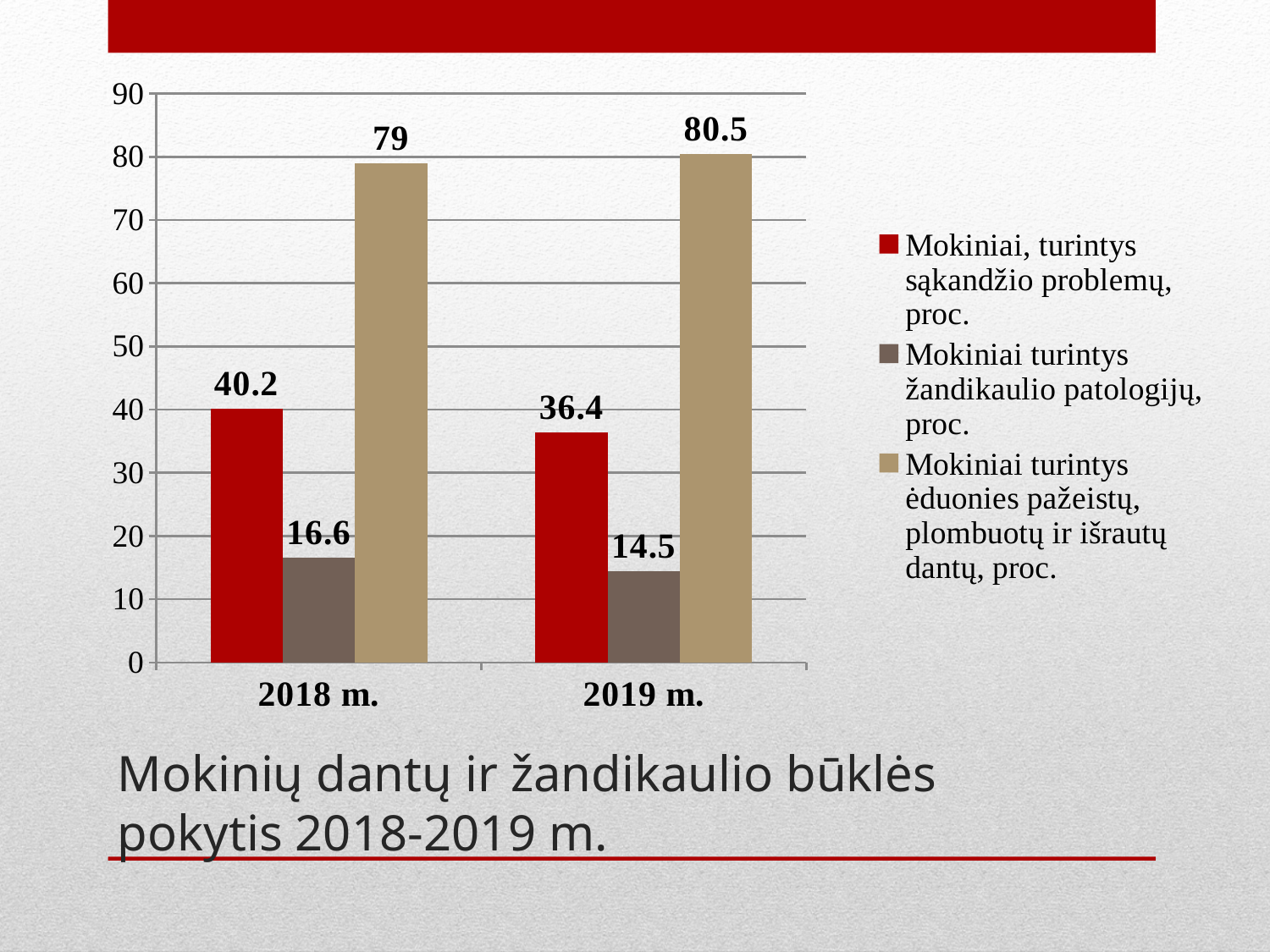
What kind of chart is shown on the slide? bar chart What is the value for 'Mokiniai turintys ėduonies pažeistų, plombuotų ir išrautų dantų, proc.' in 2019 m.? 80.5 What is the value for 'Mokiniai, turintys sąkandžio problemų, proc.' in 2018 m.? 40.2 What is the difference between the 2018 m. and 2019 m. values for 'Mokiniai, turintys sąkandžio problemų, proc.'? 3.8 Which series has the highest value in 2018 m.? Mokiniai turintys ėduonies pažeistų, plombuotų ir išrautų dantų, proc. Is the value for 'Mokiniai turintys žandikaulio patologijų, proc.' in 2018 m. greater or less than 20? less What is the value for 'Mokiniai turintys žandikaulio patologijų, proc.' in 2019 m.? 14.5 Does the value for 'Mokiniai turintys žandikaulio patologijų, proc.' rise or fall from 2018 m. to 2019 m.? fall How many series does the legend list? 3 Which series has the lowest value in 2019 m.? Mokiniai turintys žandikaulio patologijų, proc. How many categories are shown on the x axis? 2 Which year has the larger value for 'Mokiniai turintys ėduonies pažeistų, plombuotų ir išrautų dantų, proc.'? 2019 m.